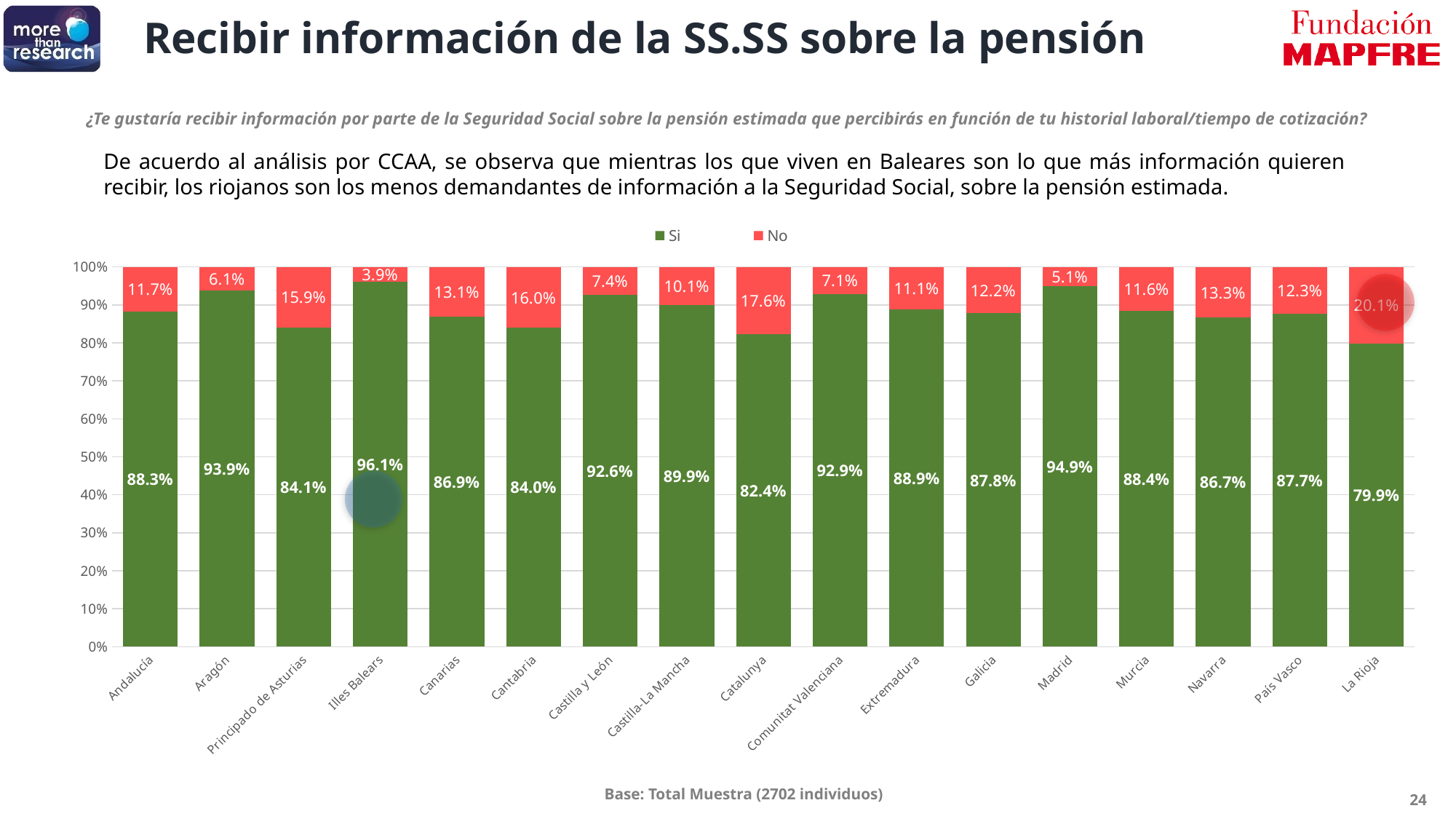
How many regions are shown on the x axis? 17 Which region has the lowest 'Si' value? La Rioja What is the 'Si' value for Illes Balears? 96.1% What is the total of the stacked bar for Aragón? 100% Which has a larger 'No' value, Cantabria or Galicia? Cantabria Which region has the highest 'Si' value? Illes Balears What is the difference between the 'Si' values for Madrid and Murcia? 6.5% What is the 'Si' value for La Rioja? 79.9% What kind of chart is shown on the slide? Stacked bar chart Which region has the highest 'No' value? La Rioja What is the 'No' value for Catalunya? 17.6% How many series does the legend list? 2